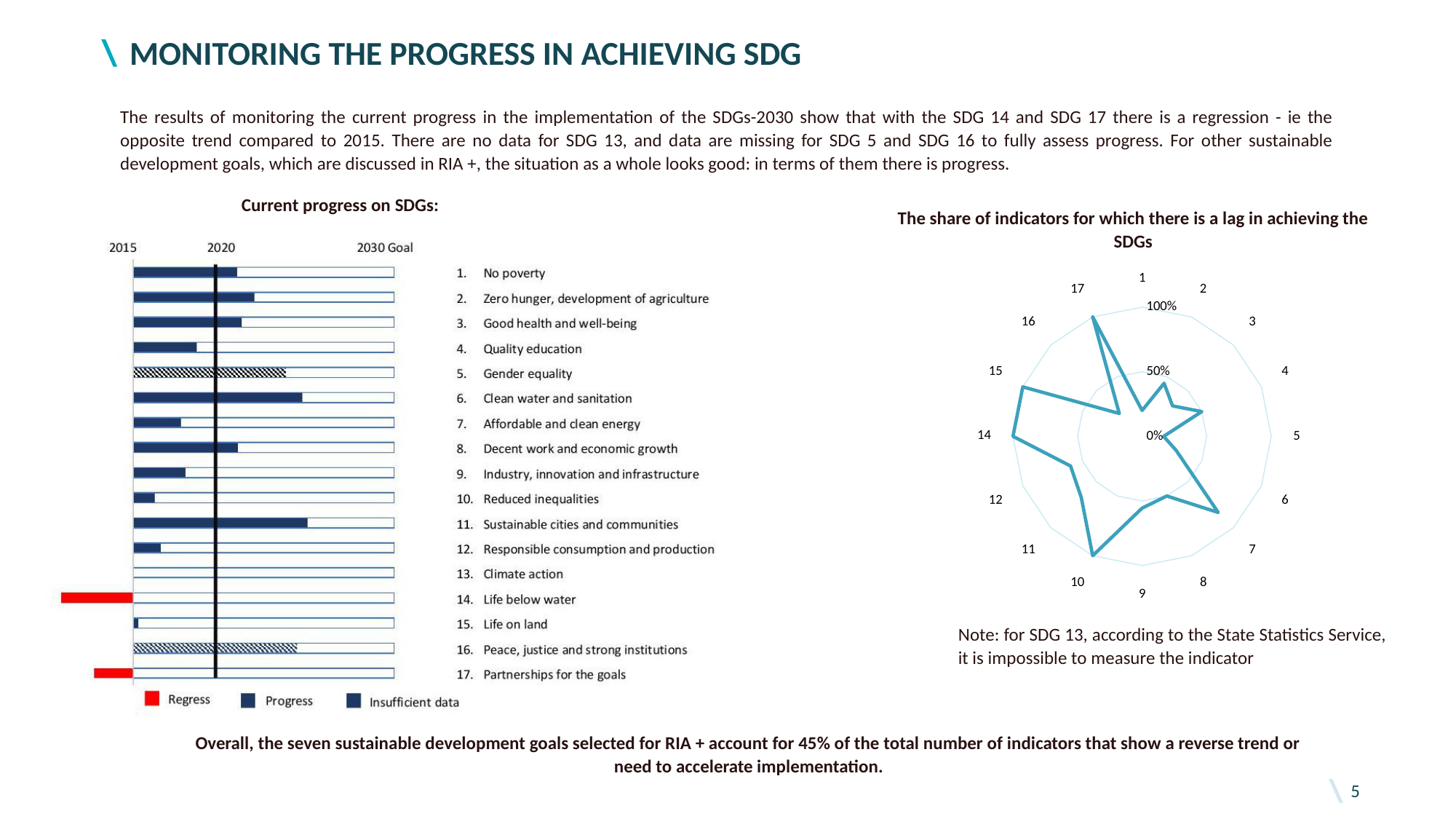
What kind of chart is 'The share of indicators for which there is a lag in achieving the SDGs' on the right? radar chart In the 'Current progress on SDGs' chart, which SDGs are shown with red 'Regress' bars? 14 (Life below water) and 17 (Partnerships for the goals) How many SDG categories are listed in the 'Current progress on SDGs' chart? 17 In the 'Current progress on SDGs' chart, which SDGs are marked with the 'Insufficient data' pattern? 5 (Gender equality) and 16 (Peace, justice and strong institutions) In the 'Current progress on SDGs' chart, which has the longer progress bar: SDG 6 (Clean water and sanitation) or SDG 10 (Reduced inequalities)? SDG 6 (Clean water and sanitation) How many entries does the legend of the 'Current progress on SDGs' chart list? 3 In the 'Current progress on SDGs' chart, which SDG has the shortest progress bar? 15 (Life on land) What kind of chart is the 'Current progress on SDGs' chart on the left? bar chart In the radar chart on the right, is the value for SDG 14 greater or less than 50%? greater In the radar chart on the right, is the value for SDG 10 greater or less than 50%? greater